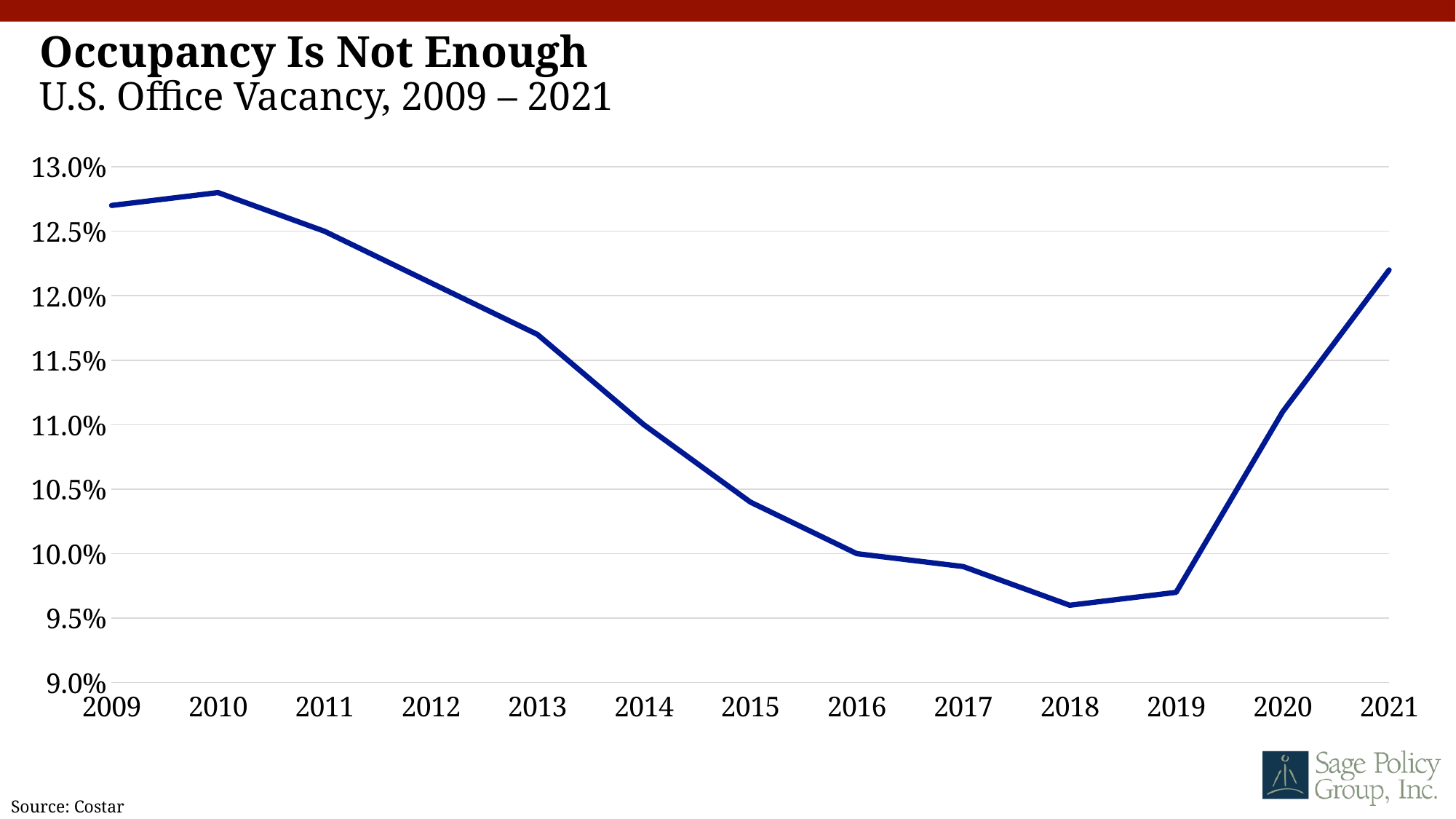
What is the source cited for the chart? Costar Is the value for 2015 greater or less than 10.5%? less Is the value for 2021 greater or less than 12.0%? greater Is the value for 2009 greater or less than 12.5%? greater What kind of chart is shown on the slide? Line chart What is the office vacancy rate in 2016? 10.0% Does the vacancy rate rise or fall from 2010 to 2018? Fall Which year has a higher vacancy rate, 2019 or 2021? 2021 In which year is the U.S. office vacancy rate lowest? 2018 How many years are plotted on the x axis? 13 In which year is the U.S. office vacancy rate highest? 2010